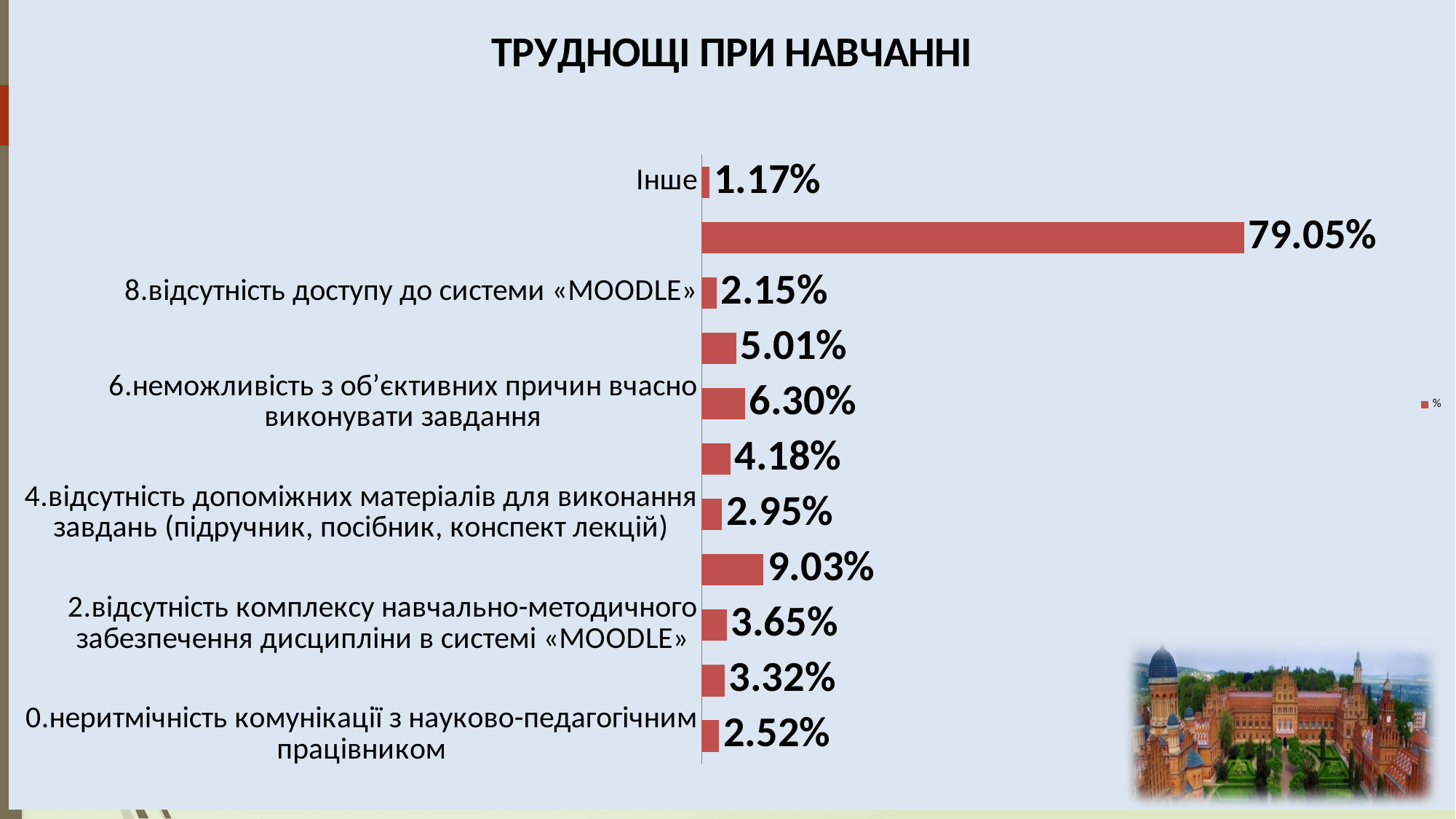
What is the value for "8.відсутність доступу до системи «MOODLE»"? 2.15% What kind of chart is shown on the slide? Bar chart Which is larger: the value for "2.відсутність комплексу навчально-методичного забезпечення дисципліни в системі «MOODLE»" or the value for "0.неритмічність комунікації з науково-педагогічним працівником"? 2.відсутність комплексу навчально-методичного забезпечення дисципліни в системі «MOODLE» What is the difference between the value for "6.неможливість з об’єктивних причин вчасно виконувати завдання" and the value for "8.відсутність доступу до системи «MOODLE»"? 4.15% What is the value for "0.неритмічність комунікації з науково-педагогічним працівником"? 2.52% Which category has the lowest value? Інше What is the value for "4.відсутність допоміжних матеріалів для виконання завдань (підручник, посібник, конспект лекцій)"? 2.95% What is the largest value shown on the chart? 79.05% How many bars are plotted on the chart? 11 What is the value for "2.відсутність комплексу навчально-методичного забезпечення дисципліни в системі «MOODLE»"? 3.65% What is the value for "Інше"? 1.17% What is the value for "6.неможливість з об’єктивних причин вчасно виконувати завдання"? 6.30%